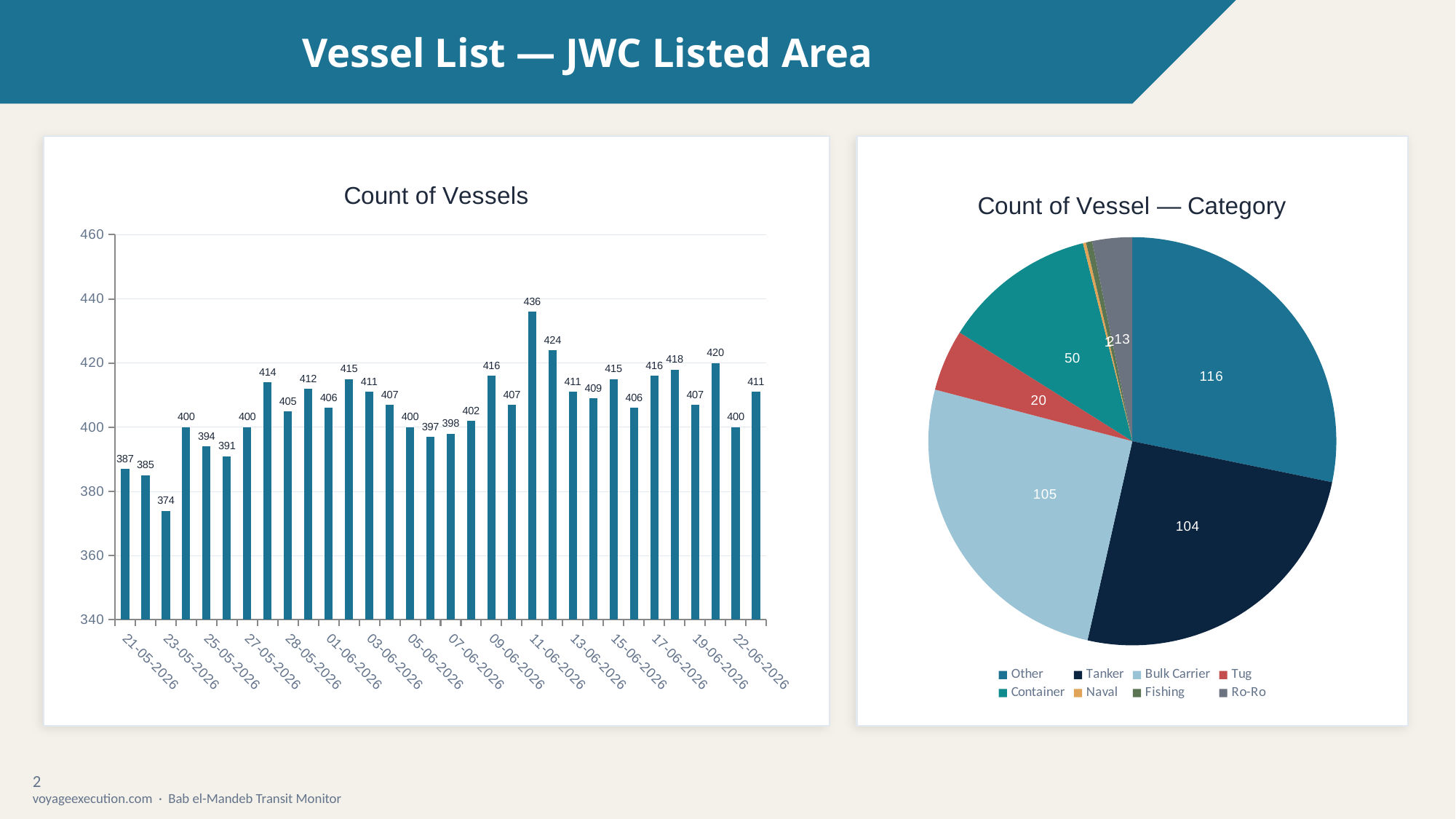
In the "Count of Vessels" chart, what is the value for 11-06-2026? 436 In the "Count of Vessel — Category" pie chart, what is the value for Other? 116 What kind of chart is the "Count of Vessel — Category" chart on the right? pie chart In the "Count of Vessel — Category" pie chart, which category has the largest slice? Other In the "Count of Vessel — Category" pie chart, what is the value for Container? 50 In the "Count of Vessels" chart, what is the lowest value shown? 374 In the "Count of Vessel — Category" pie chart, what is the value for Tanker? 104 How many categories does the legend of the "Count of Vessel — Category" pie chart list? 8 In the "Count of Vessel — Category" pie chart, what is the value for Tug? 20 What kind of chart is the "Count of Vessels" chart on the left? bar chart In the "Count of Vessels" chart, what is the difference between the highest and lowest values? 62 In the "Count of Vessels" chart, what is the highest value shown? 436